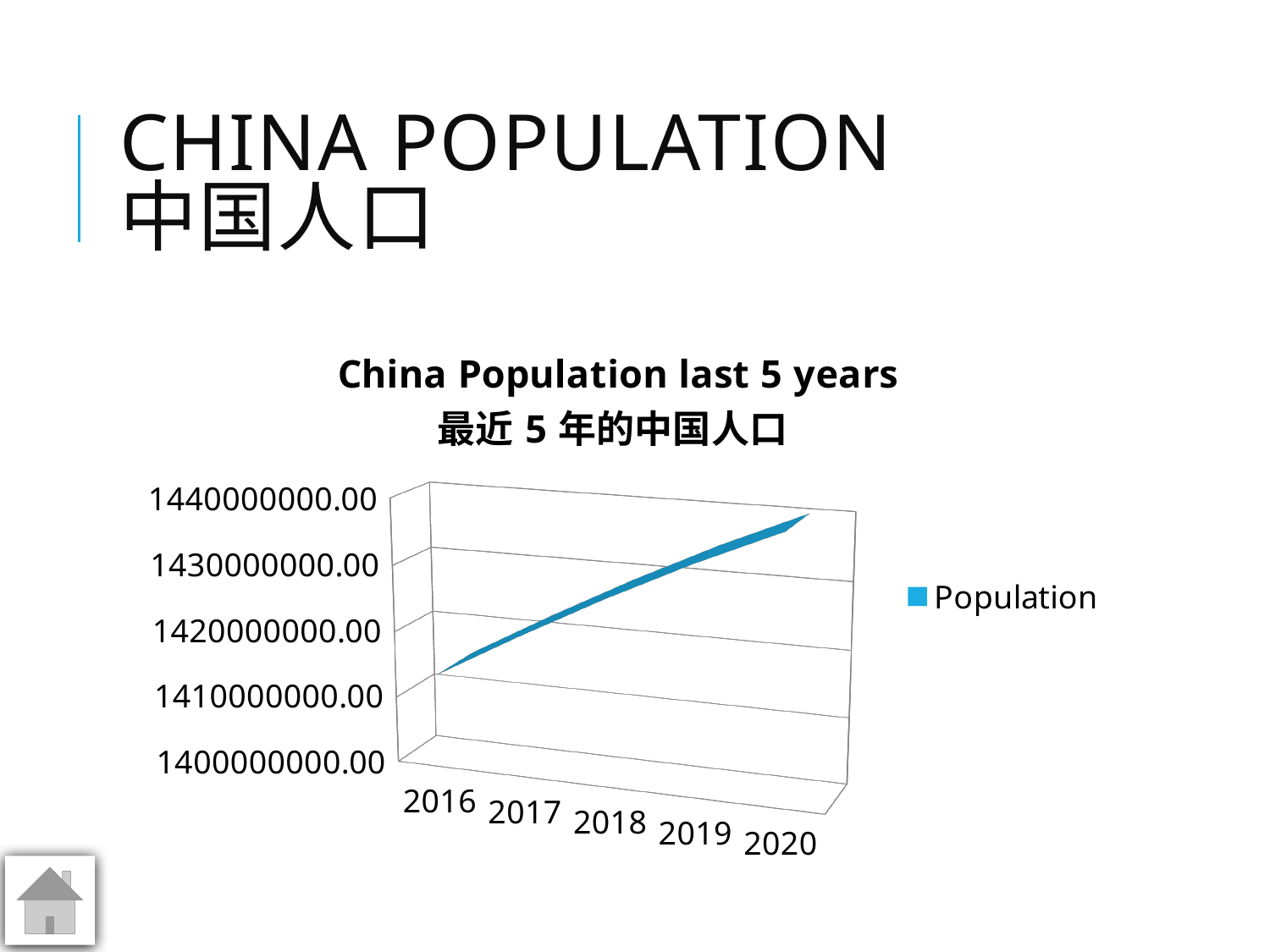
Do the population values rise or fall from 2016 to 2020? rise What is the name of the series shown in the legend? Population Is the population value for 2018 greater or less than 1420000000.00? greater What is the title of the chart? China Population last 5 years 最近 5 年的中国人口 How many years are plotted on the x axis of the chart? 5 How many series does the legend list? 1 Which year has the lowest population value? 2016 Which year has the highest population value? 2020 Which year has the larger population value, 2017 or 2019? 2019 Is the population value for 2020 greater or less than 1430000000.00? greater What kind of chart is shown on the slide? line chart Is the population value for 2016 greater or less than 1420000000.00? less